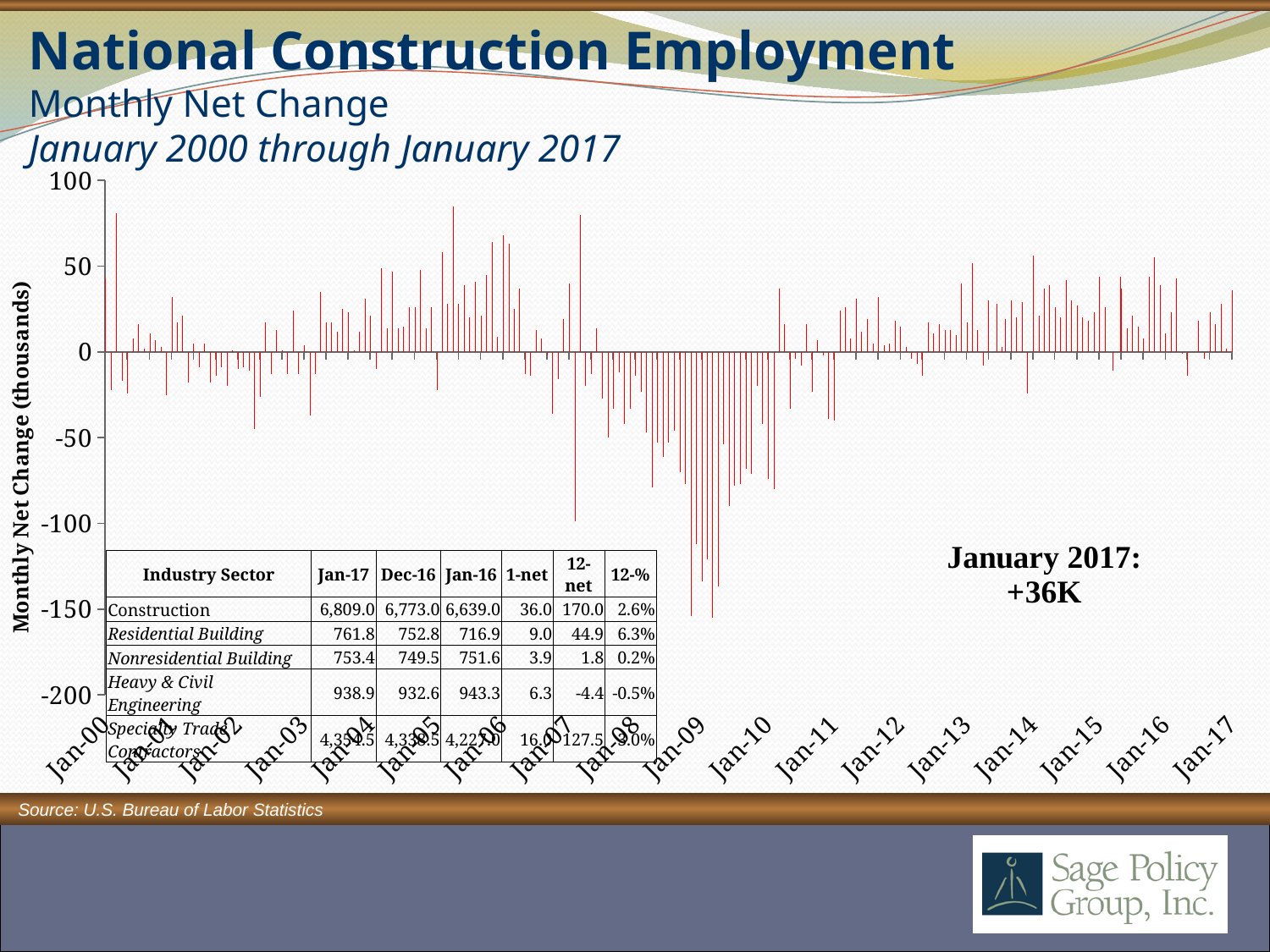
What is the lowest value shown on the vertical axis of the chart? -200 What is the time period covered by the chart, as stated in the subtitle? January 2000 through January 2017 What is the title of the chart on the slide? National Construction Employment How many year labels (Jan-00 through Jan-17) are shown along the x axis of the chart? 18 What is the label on the vertical axis of the chart? Monthly Net Change (thousands) Around which x-axis label do the largest negative monthly net changes occur? Jan-09 What kind of chart is shown on the slide? Bar chart Is the tallest positive bar on the chart, between Jan-05 and Jan-06, greater or less than 50? greater What is the highest value shown on the vertical axis of the chart? 100 Are the monthly net changes between Jan-08 and Jan-10 mostly positive or mostly negative? Mostly negative According to the annotation on the chart, what was the monthly net change in January 2017? +36K Is the lowest bar on the chart, near Jan-09, greater or less than -100? less